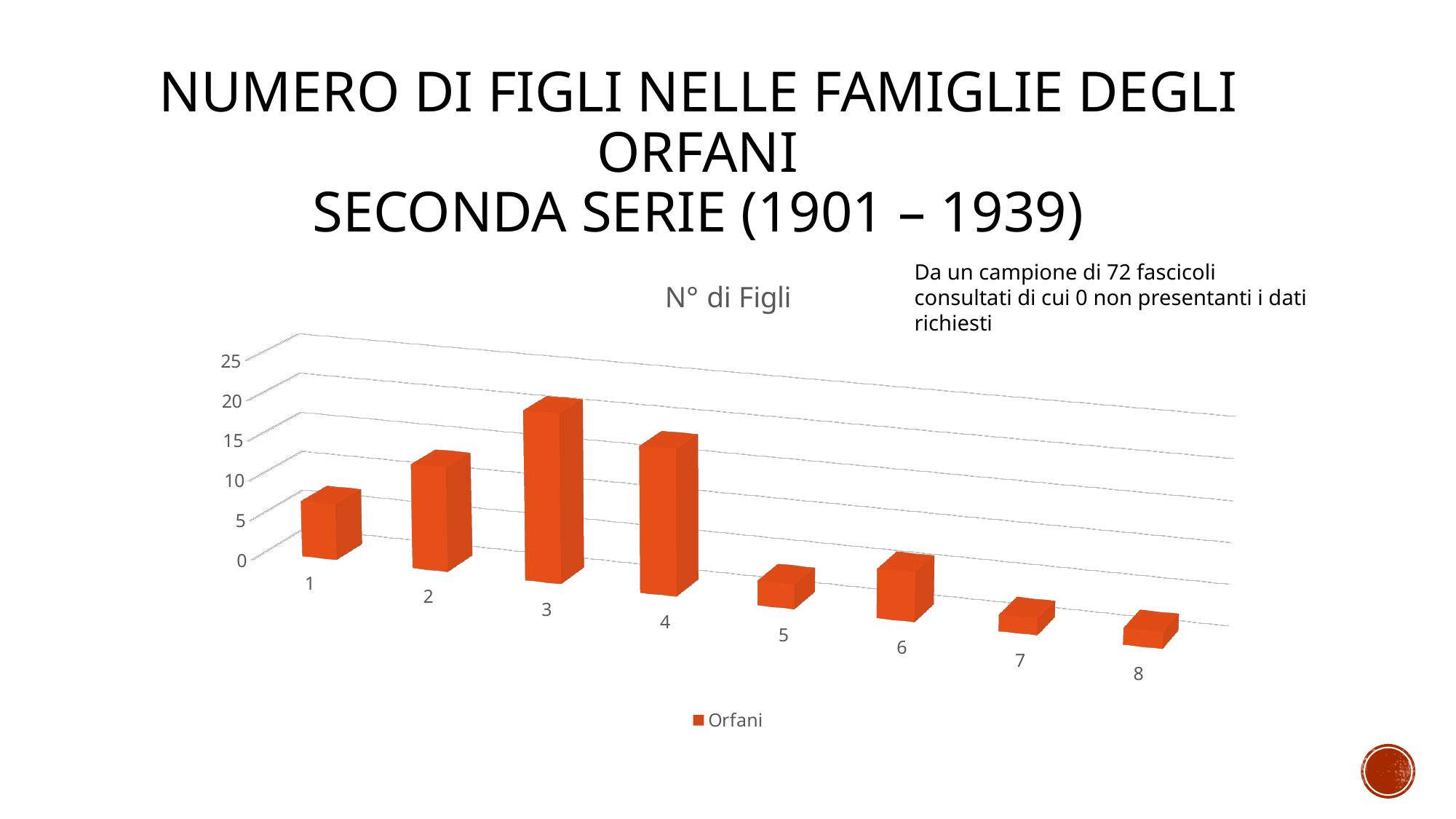
What is the title of the chart? N° di Figli Is the value for category 3 greater or less than 15? greater Which category has the highest value? 3 Which is larger, the value for category 1 or the value for category 2? 2 What is the name of the series shown in the legend? Orfani Which is larger, the value for category 3 or the value for category 4? 3 Is the value for category 5 greater or less than 10? less How many series does the legend list? 1 Which is larger, the value for category 5 or the value for category 6? 6 How many categories are shown on the x axis? 8 What kind of chart is shown on the slide? bar chart From category 1 to category 3, do the values rise or fall? rise